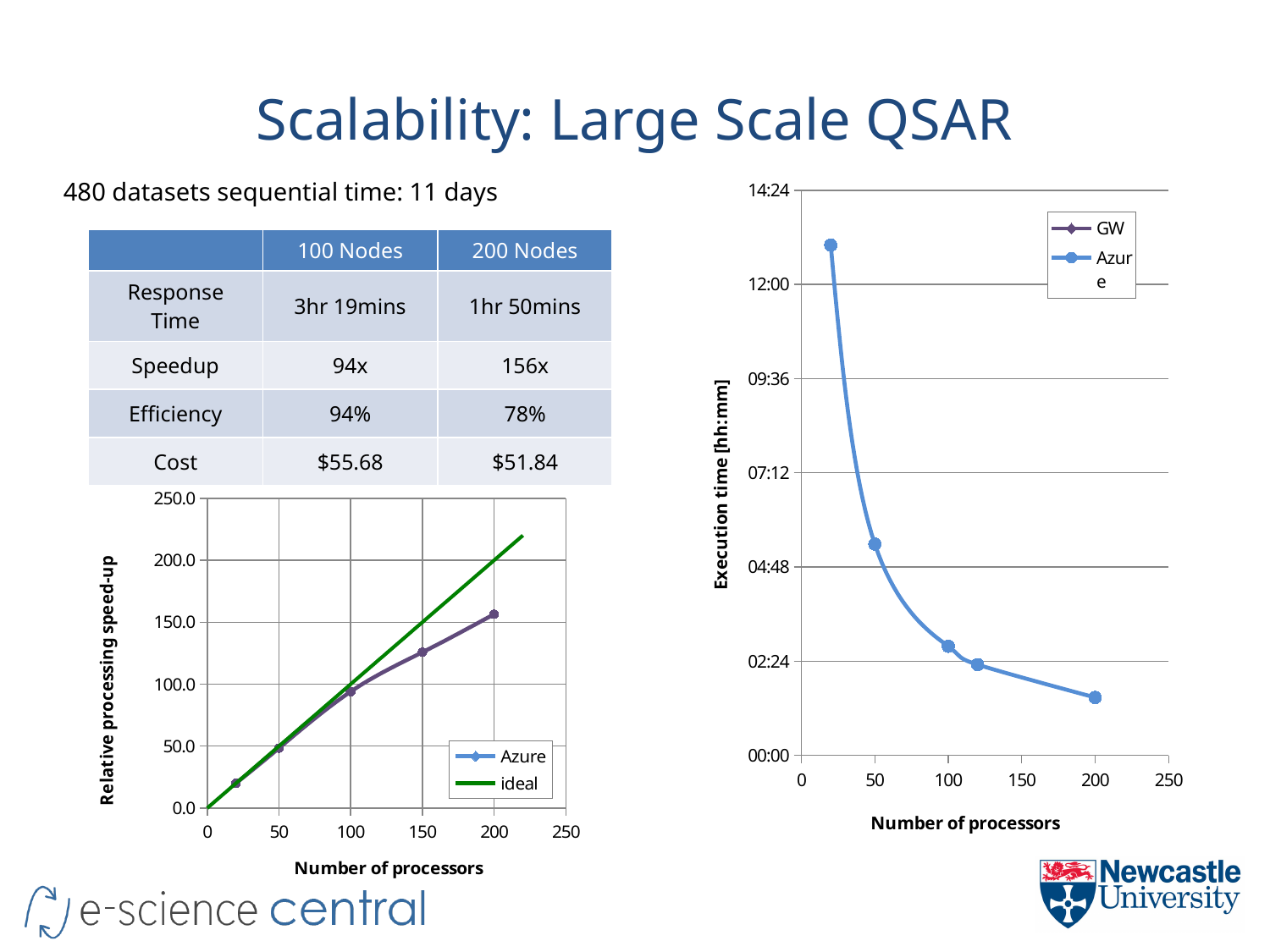
What kind of chart is the right-hand chart showing execution time? line chart In the bottom-left speed-up chart, is the Azure speed-up at 200 processors greater or less than 200.0? less How many series does the legend of the bottom-left speed-up chart list? 2 In the bottom-left speed-up chart, does the Azure series rise or fall as the number of processors increases? rise In the right-hand execution time chart, does the Azure execution time rise or fall as the number of processors increases? fall In the bottom-left speed-up chart, is the Azure speed-up at 100 processors greater or less than 50.0? greater How many data points are plotted for the Azure series in the bottom-left speed-up chart? 5 How many series does the legend of the right-hand execution time chart list? 2 What kind of chart is the bottom-left chart showing relative processing speed-up? line chart In the right-hand execution time chart, is the Azure execution time at 200 processors greater or less than 02:24? less What are the legend entries of the bottom-left speed-up chart? Azure, ideal In the bottom-left speed-up chart, at 200 processors, which series is higher: Azure or ideal? ideal